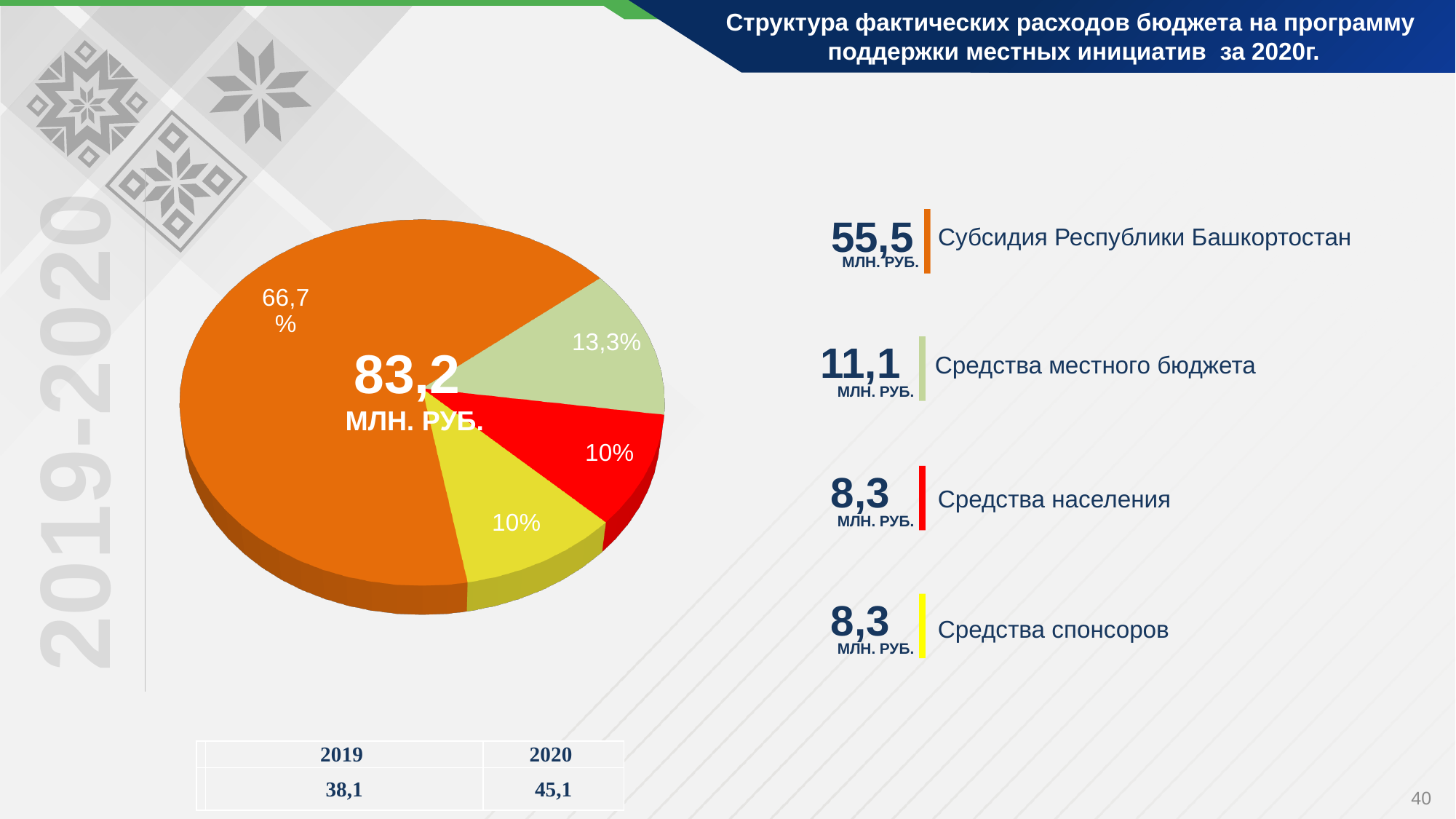
What kind of chart is shown on the slide? pie chart What is the amount shown for Средства спонсоров? 8,3 млн. руб. How many slices does the pie chart have? 4 By how many percentage points does the share of Субсидия Республики Башкортостан exceed the share of Средства местного бюджета? 53,4 What share of the pie does the largest slice (Субсидия Республики Башкортостан) represent? 66,7% Which is larger: the amount for Средства местного бюджета or the amount for Средства населения? Средства местного бюджета What share of the pie does Средства местного бюджета represent? 13,3% What share of the pie does Средства населения represent? 10% What is the amount shown for Субсидия Республики Башкортостан? 55,5 млн. руб. What is the amount shown for Средства местного бюджета? 11,1 млн. руб. Which category has the largest slice of the pie? Субсидия Республики Башкортостан What total value is printed in the centre of the pie chart? 83,2 млн. руб.